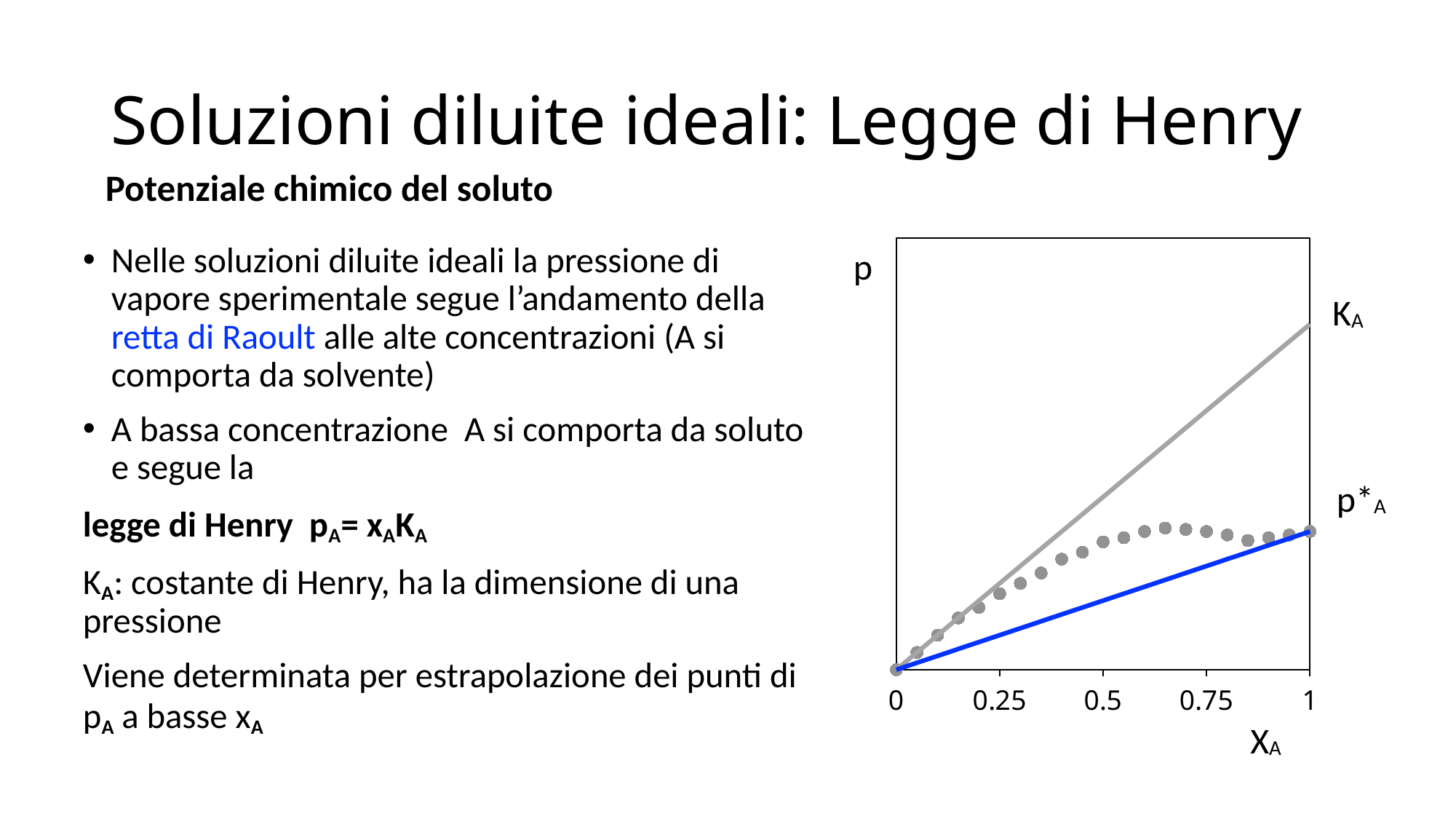
At XA = 1, which line reaches a higher value of p: the gray straight line or the blue straight line? the gray straight line Does the blue line rise or fall as XA increases from 0 to 1? rise What is the label of the x axis of the chart? XA What is the highest tick value shown on the x axis? 1 Does the gray straight line rise or fall as XA increases from 0 to 1? rise At XA = 0.25, is the dotted experimental curve above or below the blue line? above What kind of chart is shown on the slide? line chart How many tick labels are shown on the x axis of the chart? 5 What is the lowest tick value shown on the x axis? 0 What label is written at the upper end of the gray straight line? KA